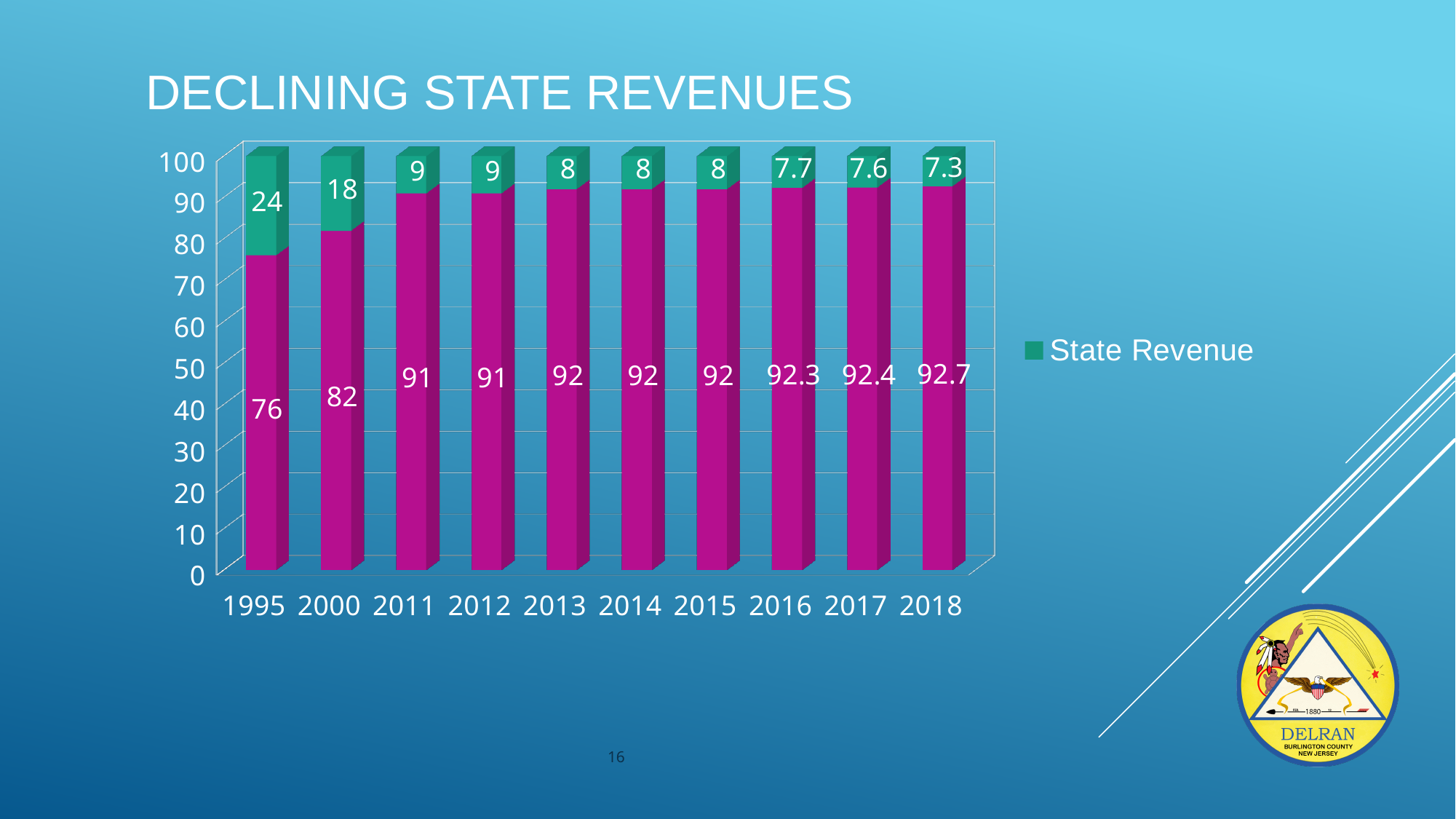
What kind of chart is shown on the slide? Stacked bar chart How many years are shown on the x axis? 10 What is the value of the magenta (lower) segment for 2000? 82 Do the State Revenue values rise or fall from 1995 to 2018? Fall How many series does the legend list? 1 Which year has the larger State Revenue value, 2011 or 2013? 2011 Which year has the highest State Revenue value? 1995 What is the State Revenue value for 2018? 7.3 Which year has the lowest State Revenue value? 2018 What is the difference between the State Revenue values for 1995 and 2000? 6 What is the title of the chart? DECLINING STATE REVENUES What is the State Revenue value for 1995? 24